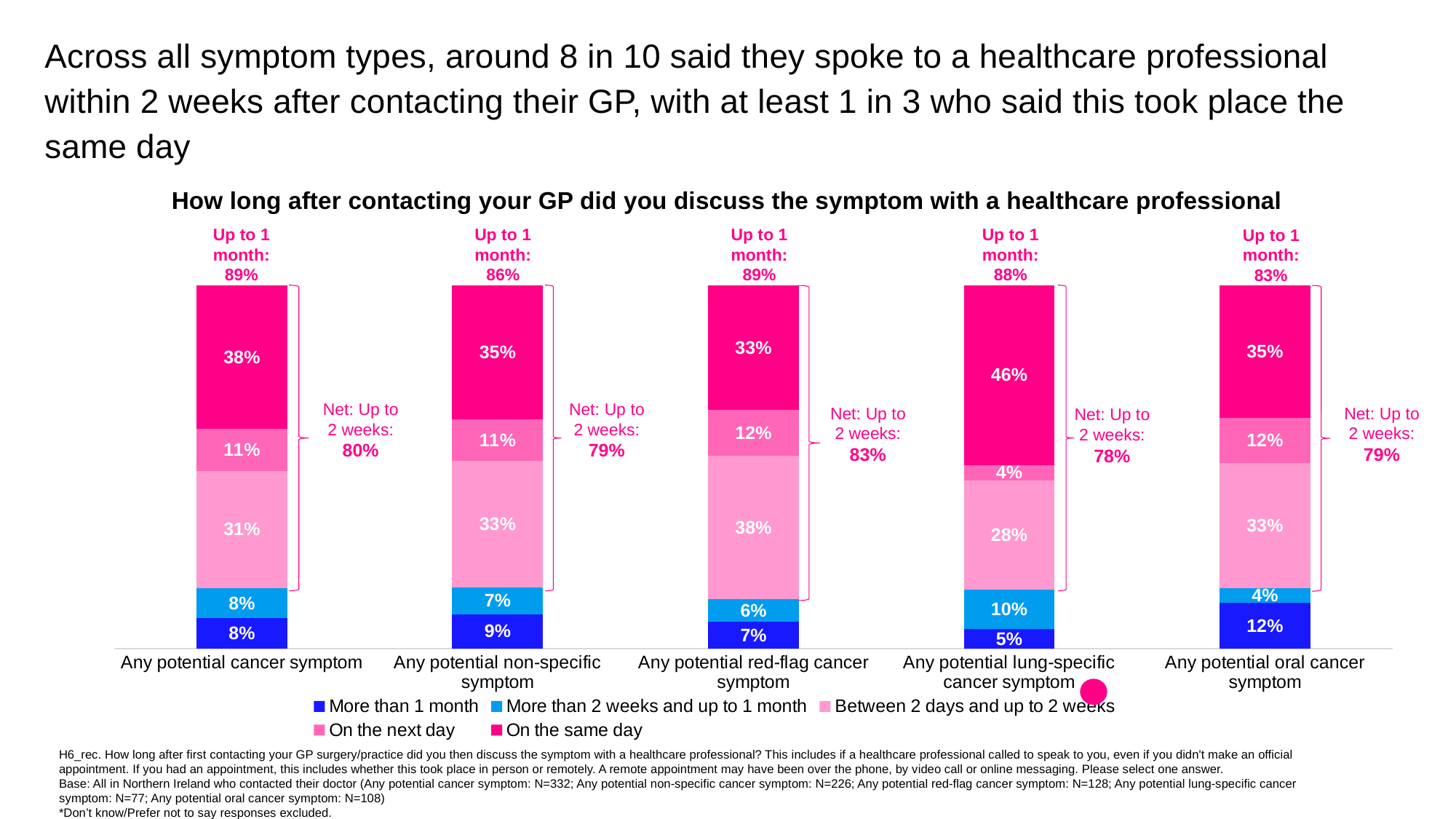
Which is larger: the 'Between 2 days and up to 2 weeks' value for any potential red-flag cancer symptom or for any potential lung-specific cancer symptom? Any potential red-flag cancer symptom What is the 'Up to 1 month' figure for any potential oral cancer symptom? 83% What kind of chart is shown on the slide? Stacked bar chart What is the 'Net: Up to 2 weeks' figure for any potential red-flag cancer symptom? 83% What percentage of respondents with any potential lung-specific cancer symptom discussed the symptom on the same day? 46% Which symptom type has the lowest share of respondents who discussed the symptom on the next day? Any potential lung-specific cancer symptom How many symptom types (categories) are shown on the chart? 5 What is the title of the chart? How long after contacting your GP did you discuss the symptom with a healthcare professional What percentage of respondents with any potential non-specific symptom said it took more than 1 month? 9% Which symptom type has the highest share of respondents who discussed the symptom on the same day? Any potential lung-specific cancer symptom What is the difference in percentage points between the 'On the same day' values for any potential lung-specific cancer symptom and any potential cancer symptom? 8 percentage points How many series does the legend list? 5